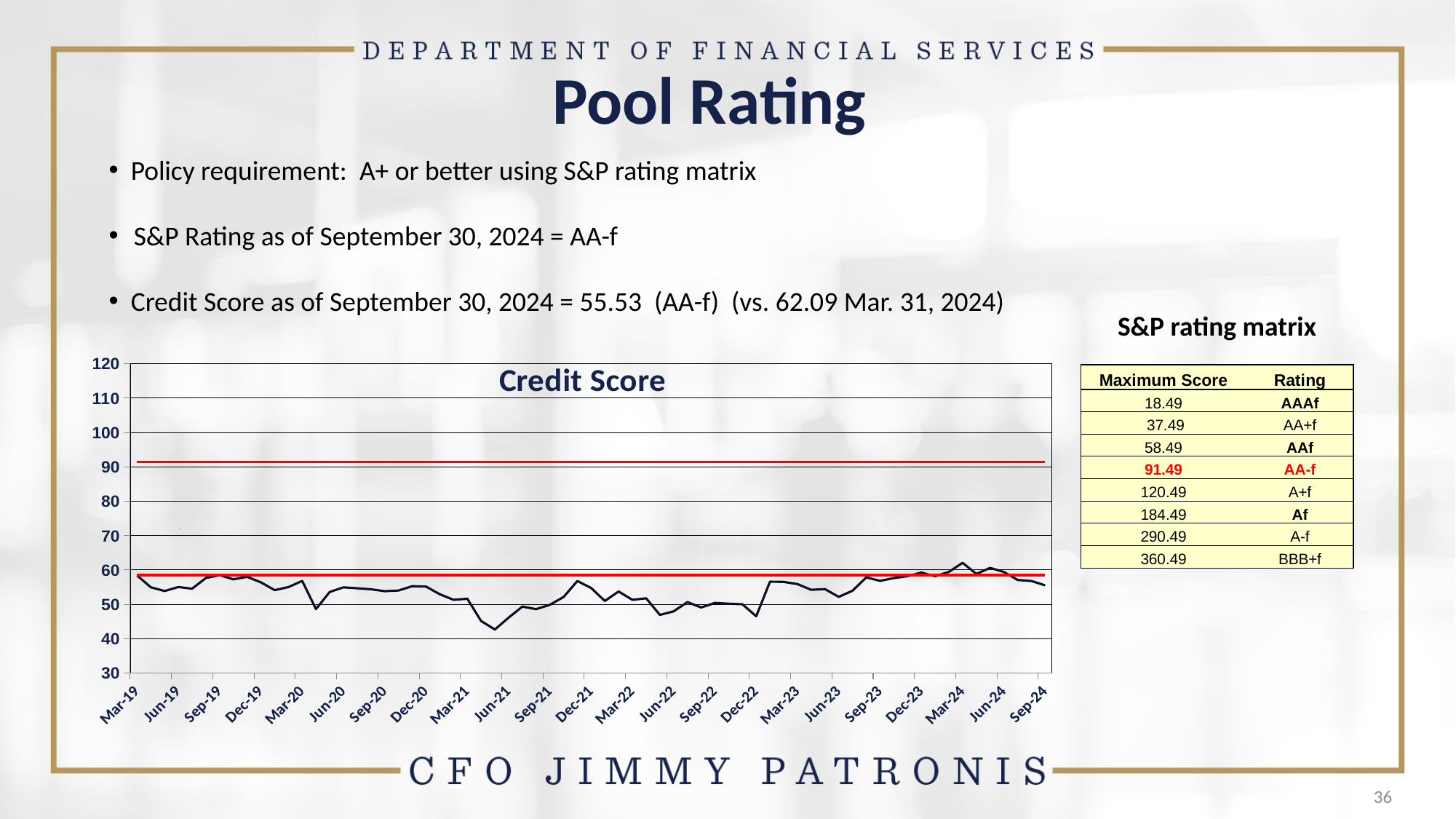
Which is larger, the credit score at Jun-21 or at Mar-24? Mar-24 What kind of chart is the Credit Score chart? line chart Is the credit score at Jun-21 greater or less than 50? less How many date labels are shown on the x axis of the Credit Score chart? 23 Is the credit score at Mar-24 greater or less than 60? greater Is the credit score at Sep-24 greater or less than 60? less Around which x-axis label does the credit score reach its lowest point? Jun-21 Does the credit score generally rise or fall between Jun-21 and Mar-24? rise What is the highest value shown on the y axis of the Credit Score chart? 120 What is the title of the chart on the slide? Credit Score